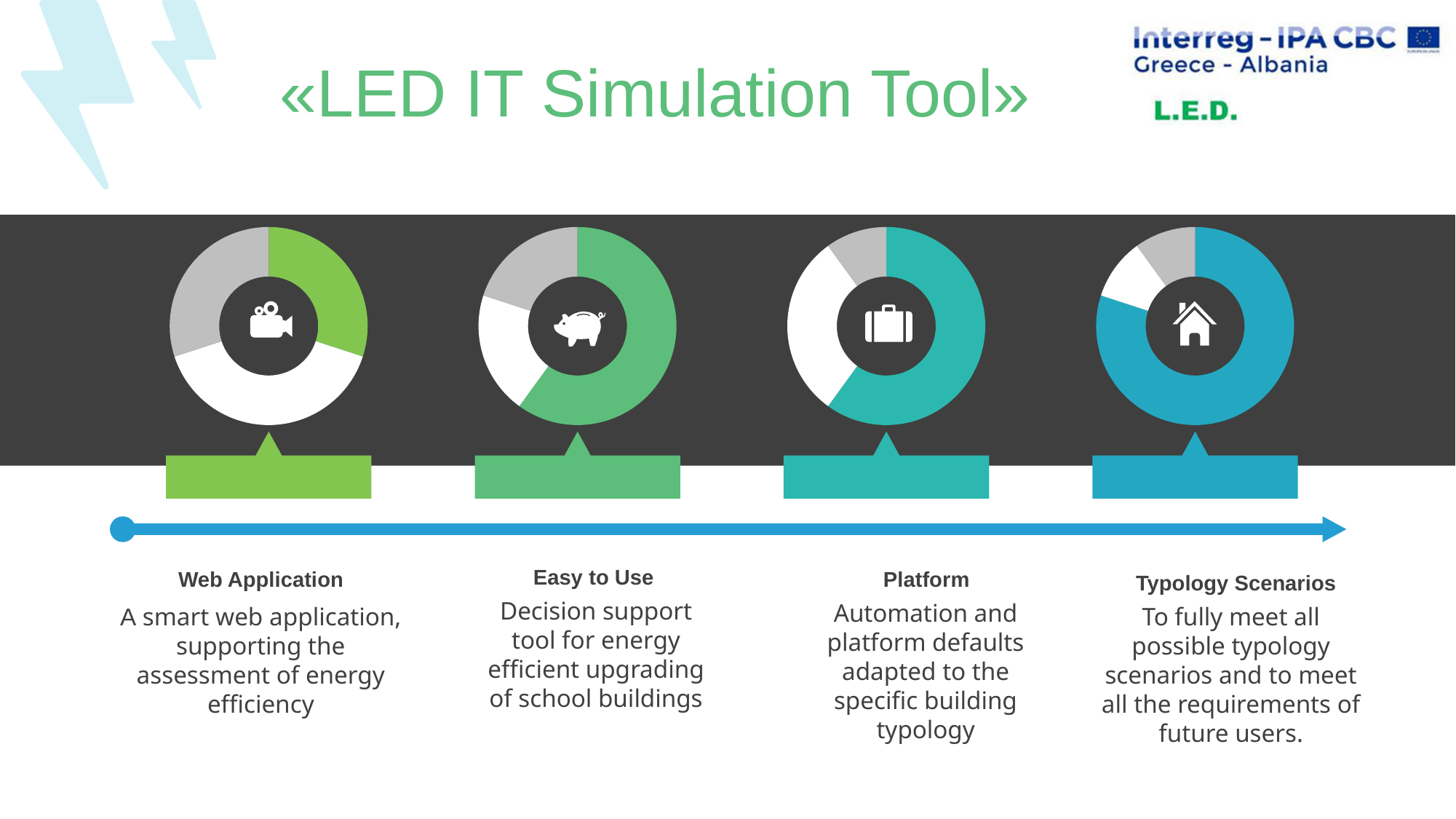
What icon appears in the centre of the donut chart above 'Easy to Use'? A piggy bank What kind of chart is shown above the 'Web Application' label? Donut (pie) chart Which of the four donut charts has the smallest coloured (non-grey, non-white) segment? Web Application How many donut charts are shown on the slide? 4 What colour is the main segment of the donut chart above 'Platform'? Teal Which of the four donut charts has the largest coloured (non-grey, non-white) segment? Typology Scenarios Is the coloured segment larger in the 'Web Application' donut or in the 'Typology Scenarios' donut? Typology Scenarios Is the coloured segment of the 'Web Application' donut greater or less than half of the ring? less Is the coloured segment of the 'Typology Scenarios' donut greater or less than half of the ring? greater